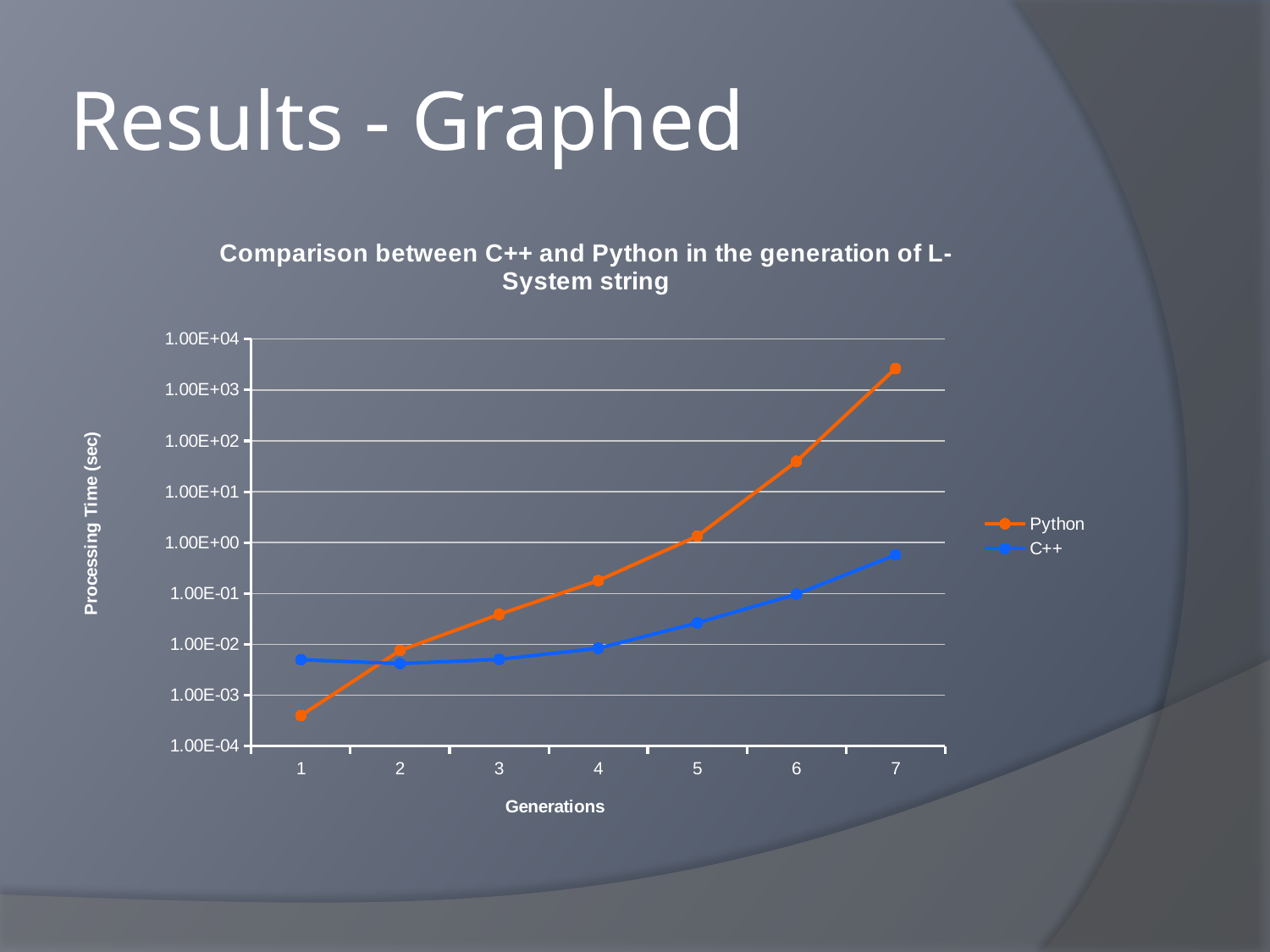
At generation 7, which series has the higher processing time, Python or C++? Python How many generations are plotted along the x axis? 7 Is the C++ processing time at generation 7 greater or less than 1.00E+00? less What kind of chart is shown on the slide? line chart What is the label of the y axis? Processing Time (sec) At generation 1, which series has the higher processing time, Python or C++? C++ Is the Python processing time at generation 6 greater or less than 1.00E+01? greater How many series does the legend list? 2 Is the Python processing time at generation 1 greater or less than 1.00E-03? less Does the Python processing time rise or fall as the generations increase? rise